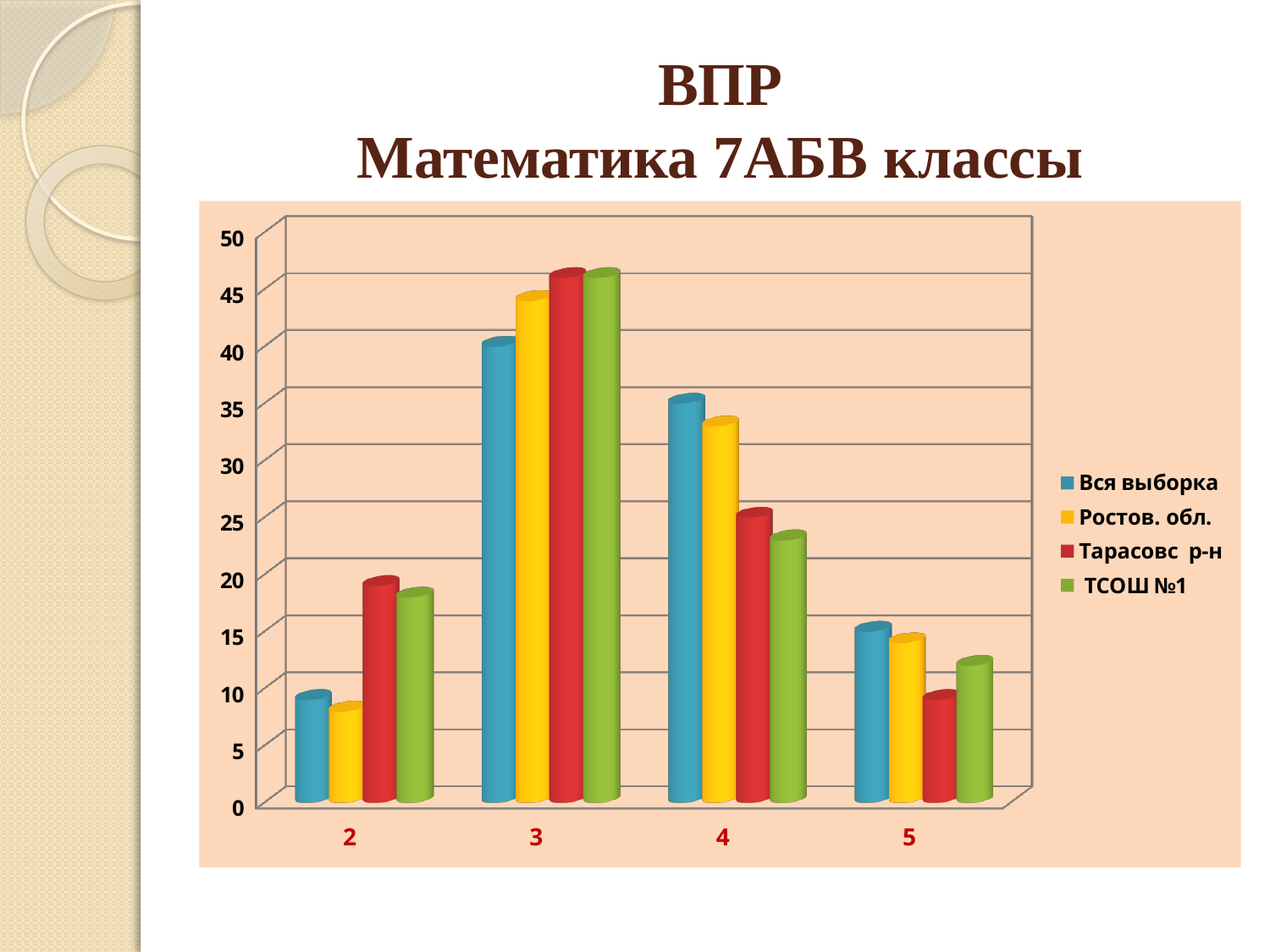
Is the value for Ростов. обл. at category 4 greater or less than 30? greater For the series Тарасовс р-н, which category has the lowest value? 5 Is the value for Тарасовс р-н at category 2 greater or less than 15? greater For the series Вся выборка, which category has the highest value? 3 Is the value for Вся выборка at category 3 greater or less than 30? greater How many series does the legend list? 4 How many categories are shown on the x axis of the chart? 4 What kind of chart is shown on the slide? bar chart Do the values for Вся выборка rise or fall from category 3 to category 5? fall At category 4, which is larger: Вся выборка or ТСОШ №1? Вся выборка